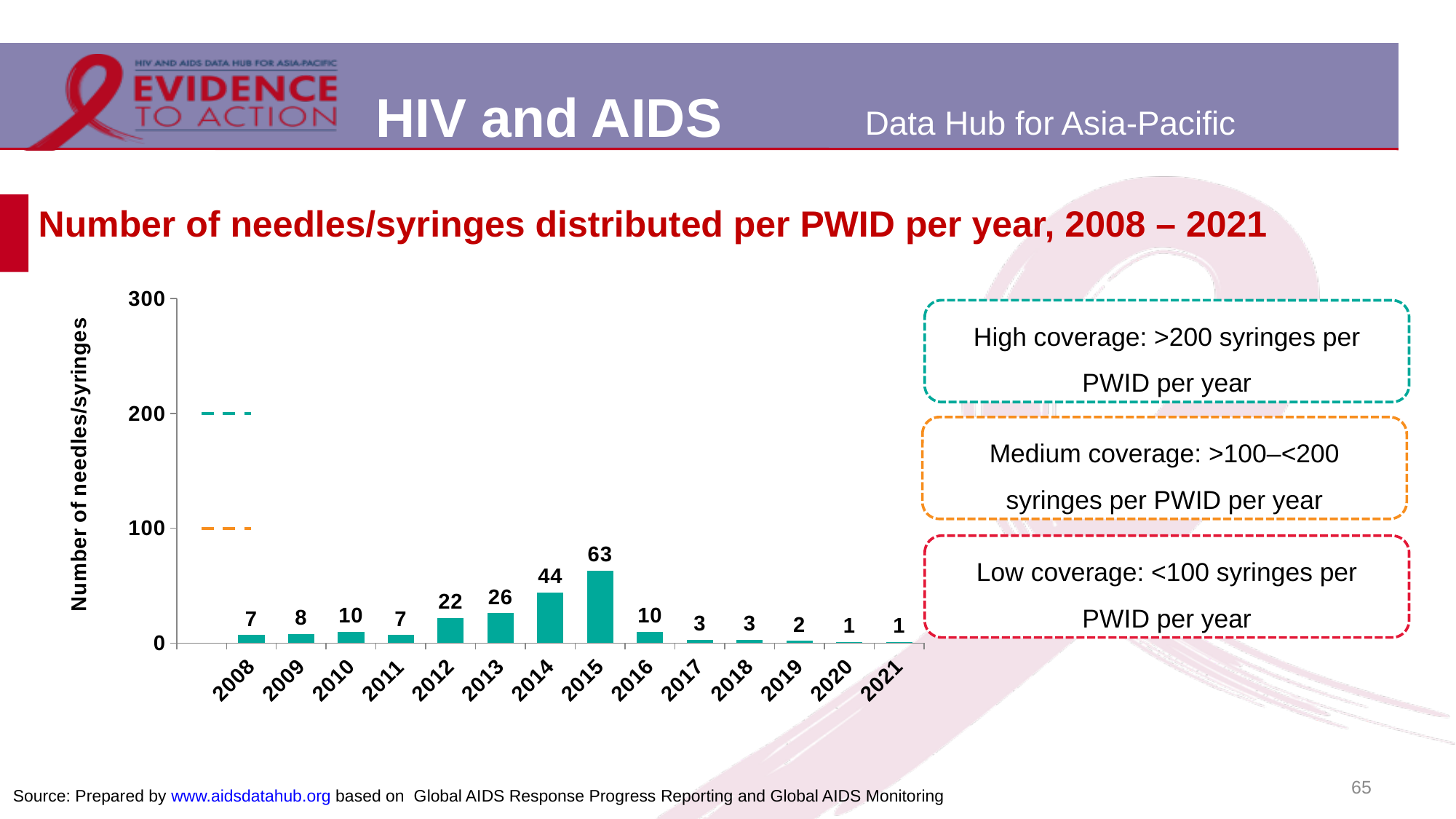
What is the number of needles/syringes distributed per PWID per year in 2015? 63 How many years are shown on the x axis? 14 What kind of chart is shown on the slide? bar chart What is the difference between the values for 2015 and 2014? 19 What is the label of the y axis? Number of needles/syringes Is the value for 2015 greater or less than 100? less What is the value shown for 2012? 22 What is the value shown for 2021? 1 Which is larger, the value for 2013 or the value for 2016? 2013 According to the slide, what level of coverage is more than 200 syringes per PWID per year? High coverage Which year has the highest number of needles/syringes distributed per PWID? 2015 Do the values rise or fall from 2015 to 2021? fall